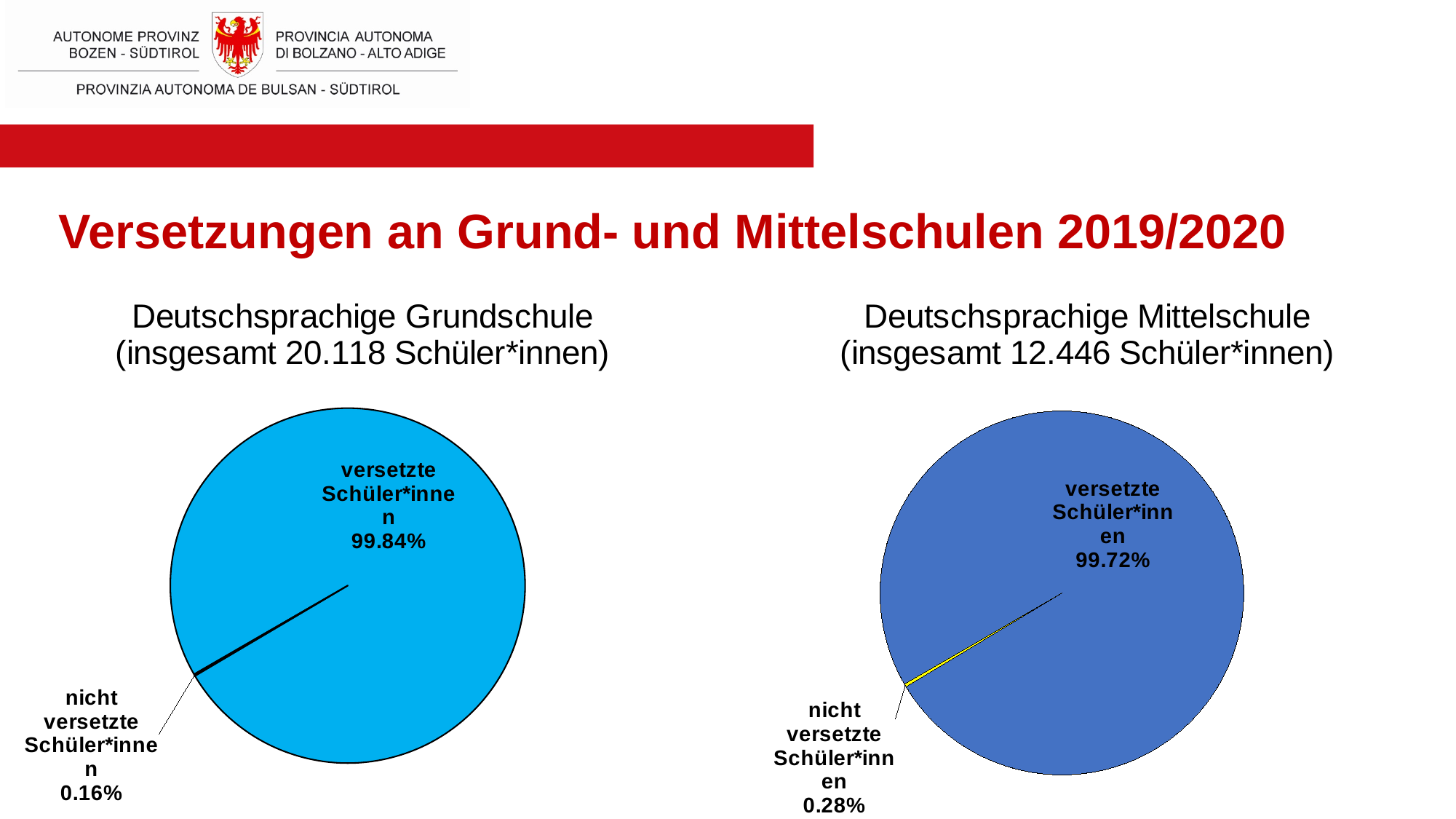
In the Deutschsprachige Grundschule chart, what share of students are 'nicht versetzte Schüler*innen'? 0.16% In the Deutschsprachige Mittelschule chart, which slice is the smallest? nicht versetzte Schüler*innen What is the title of the slide containing the two pie charts? Versetzungen an Grund- und Mittelschulen 2019/2020 How many slices does the Deutschsprachige Mittelschule pie chart have? 2 What kind of chart is used for the Deutschsprachige Grundschule data? Pie chart In the Deutschsprachige Grundschule chart, which slice is the largest? versetzte Schüler*innen How many students in total does the Deutschsprachige Grundschule chart cover, according to its subtitle? 20.118 In the Deutschsprachige Grundschule chart, what share of students are 'versetzte Schüler*innen'? 99.84% What is the difference between the 'versetzte Schüler*innen' share in the Grundschule chart and in the Mittelschule chart? 0.12% Which chart shows a higher share of 'nicht versetzte Schüler*innen', the Grundschule chart or the Mittelschule chart? Mittelschule In the Deutschsprachige Mittelschule chart, what share of students are 'versetzte Schüler*innen'? 99.72% In the Deutschsprachige Mittelschule chart, what share of students are 'nicht versetzte Schüler*innen'? 0.28%